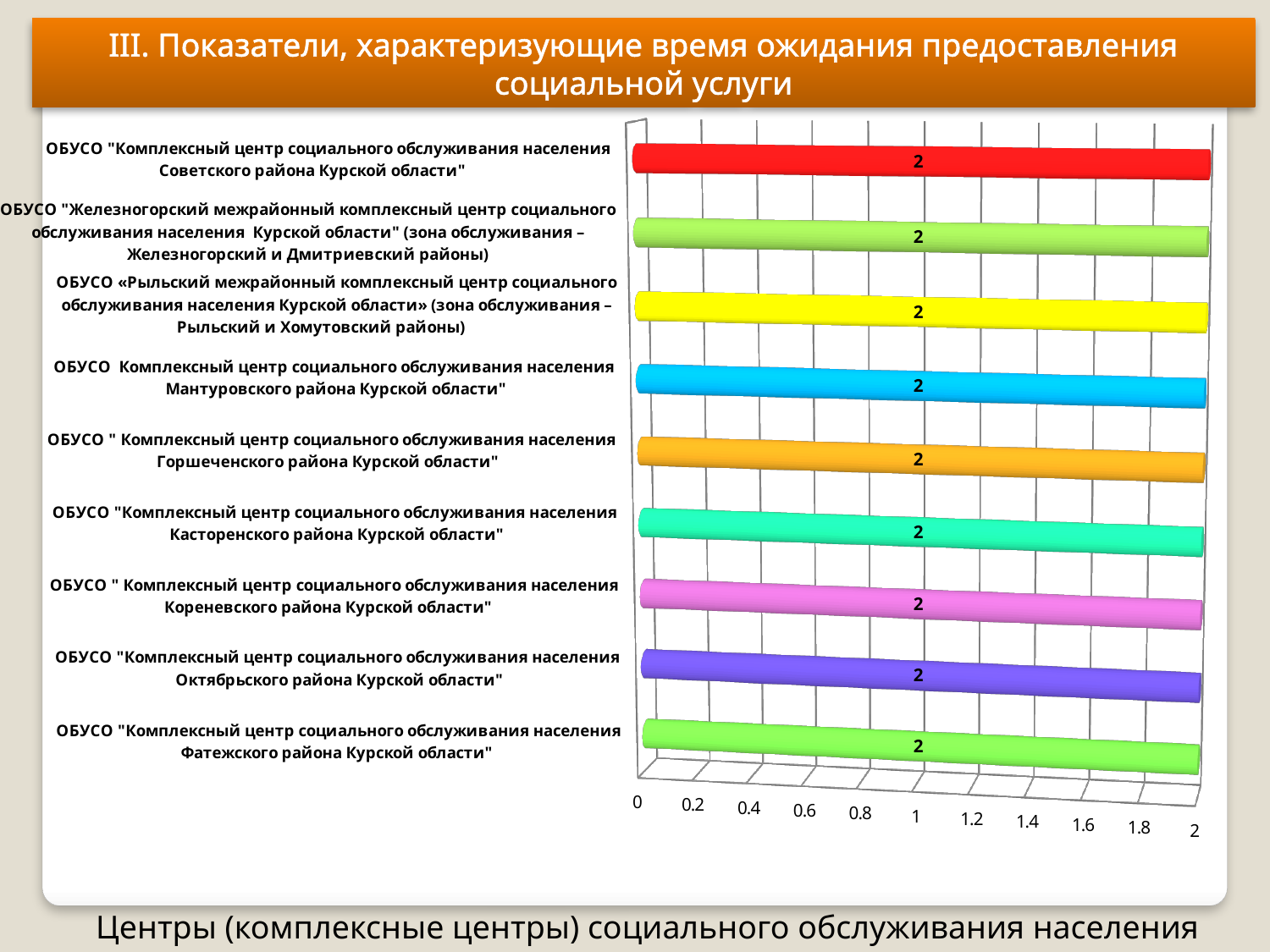
Is the value for the Рыльский межрайонный комплексный центр greater or less than 1.8? greater Is the value for ОБУСО "Комплексный центр социального обслуживания населения Кореневского района Курской области" greater or less than 1? greater What is the value for ОБУСО "Комплексный центр социального обслуживания населения Советского района Курской области"? 2 Do the values differ between the centres, or are they all the same? All the same What is the value for ОБУСО "Комплексный центр социального обслуживания населения Мантуровского района Курской области"? 2 What is the difference between the value for the Горшеченского района centre and the value for the Касторенского района centre? 0 What is the highest tick value shown on the horizontal axis? 2 How many categories (centres) are plotted in the chart? 9 What is the value for ОБУСО "Комплексный центр социального обслуживания населения Фатежского района Курской области"? 2 What colour is the bar for ОБУСО "Комплексный центр социального обслуживания населения Советского района Курской области"? Red What kind of chart is shown on the slide? Bar chart What is the value for ОБУСО "Комплексный центр социального обслуживания населения Октябрьского района Курской области"? 2